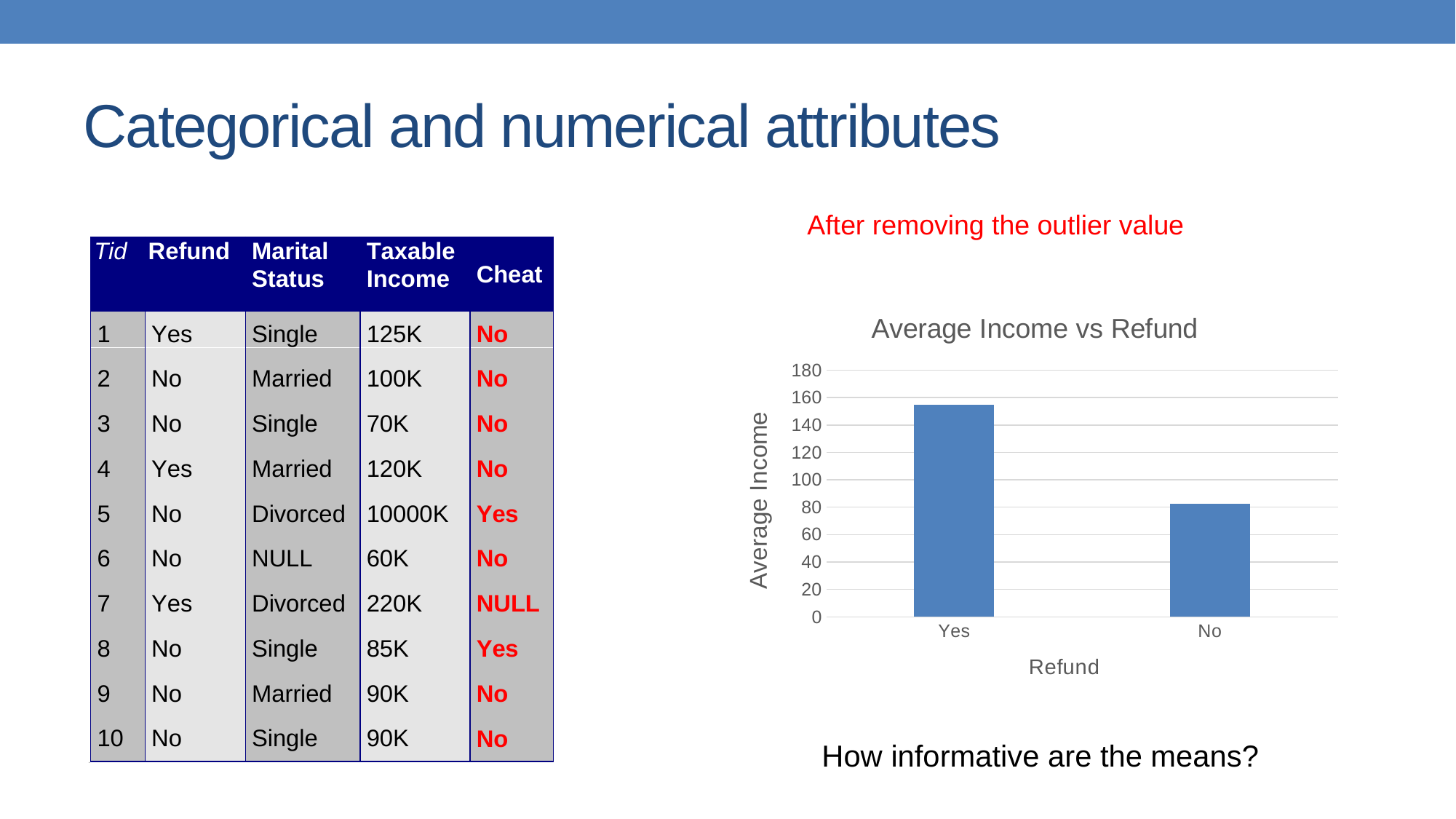
Is the average income for Refund = No greater or less than 60? greater Is the average income for Refund = Yes greater or less than 160? less Which Refund category has the lowest average income? No What kind of chart is shown on the slide? bar chart Which Refund category has the highest average income? Yes Do the bar values rise or fall moving from Yes to No along the x axis? fall How many categories are shown on the x axis of the Average Income vs Refund chart? 2 Which has a larger average income, Refund = Yes or Refund = No? Yes Is the average income for Refund = No greater or less than 100? less What is the title of the chart? Average Income vs Refund What is the label on the y axis of the chart? Average Income